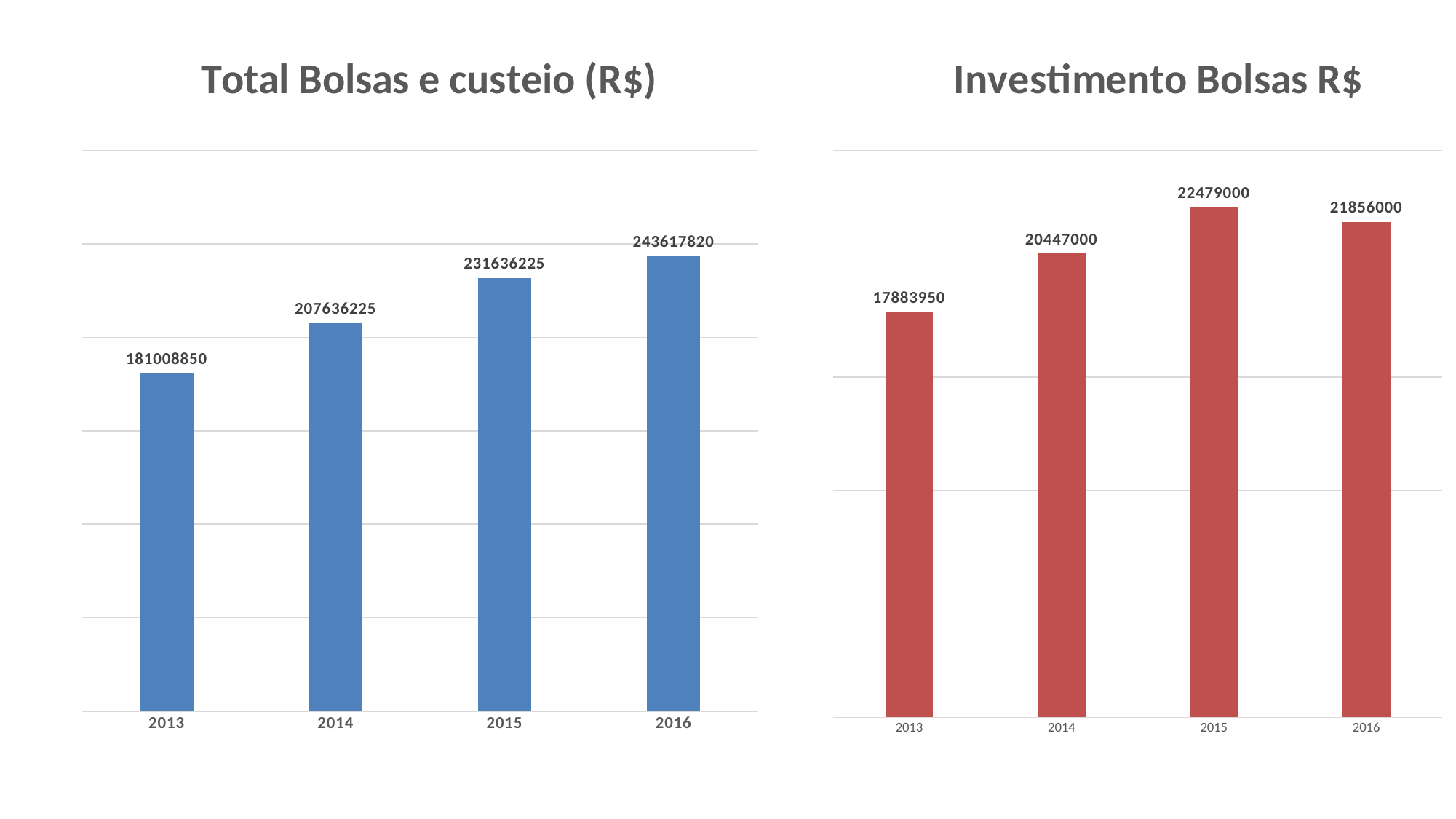
In the 'Total Bolsas e custeio (R$)' chart, what is the difference between the values for 2015 and 2014? 24000000 In the 'Investimento Bolsas R$' chart, which year has the highest value? 2015 In the 'Investimento Bolsas R$' chart, which is larger, the value for 2014 or the value for 2016? 2016 In the 'Investimento Bolsas R$' chart, what is the value for 2016? 21856000 In the 'Investimento Bolsas R$' chart, what is the value for 2014? 20447000 In the 'Total Bolsas e custeio (R$)' chart, which year has the lowest value? 2013 In the 'Total Bolsas e custeio (R$)' chart, what is the value for 2016? 243617820 What kind of chart is the 'Investimento Bolsas R$' chart? bar chart In the 'Total Bolsas e custeio (R$)' chart, do the values rise or fall from 2013 to 2016? rise In the 'Investimento Bolsas R$' chart, what is the difference between the values for 2015 and 2016? 623000 In the 'Total Bolsas e custeio (R$)' chart, what is the value for 2013? 181008850 How many years are shown in the 'Total Bolsas e custeio (R$)' chart? 4